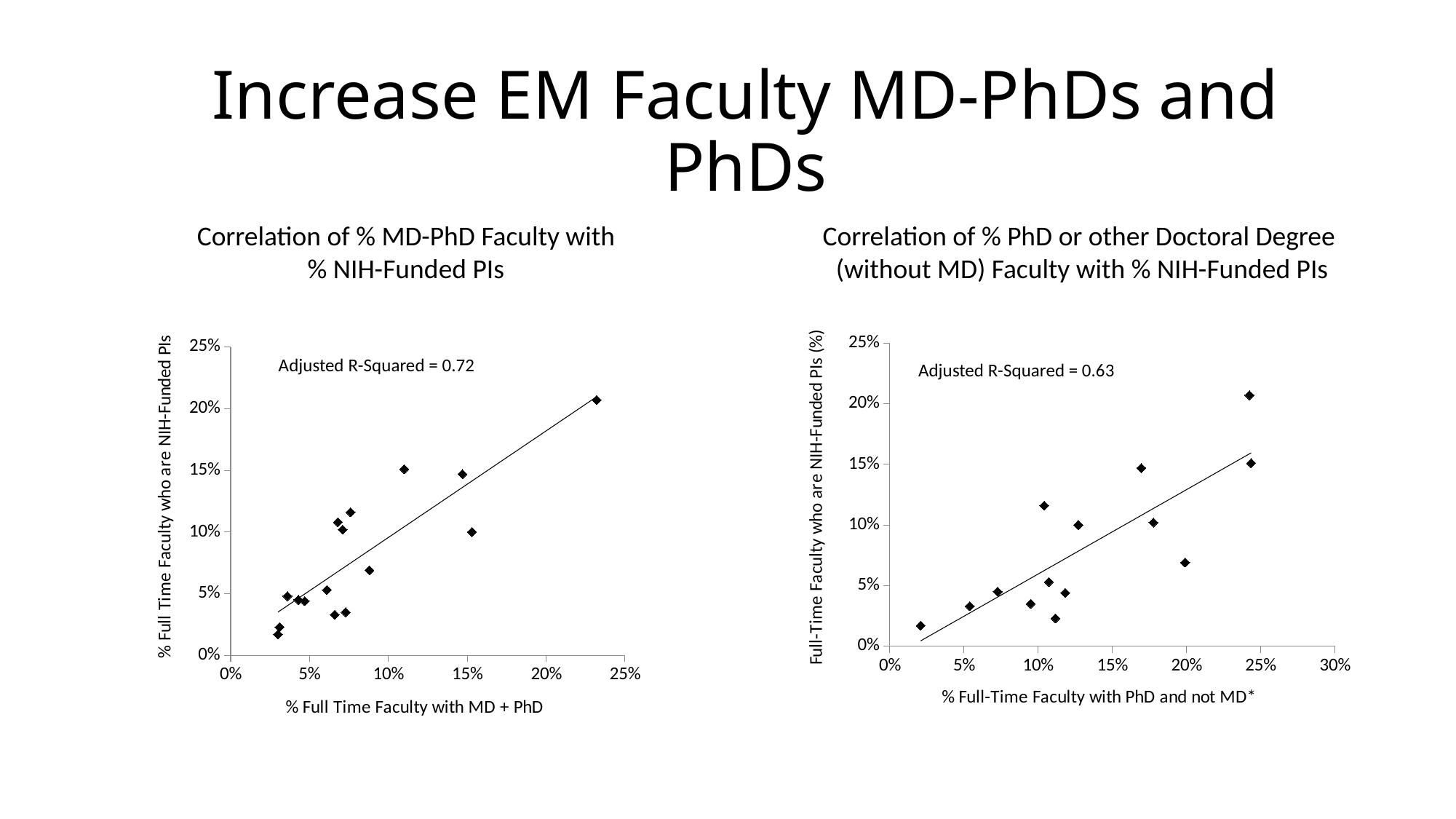
What kind of chart is the left chart, 'Correlation of % MD-PhD Faculty with % NIH-Funded PIs'? scatter plot What is the maximum value shown on the x axis of the right chart? 30% In the right chart, does the trend line rise or fall as % full-time faculty with PhD and not MD increases? rise In the left chart, do the values of % NIH-funded PIs generally rise or fall as % full time faculty with MD + PhD increases? rise In the left chart, is the y-value of the leftmost data points (at about 3% on the x axis) greater or less than 5%? less What is the Adjusted R-Squared value shown on the left chart? 0.72 What kind of chart is the right chart, 'Correlation of % PhD or other Doctoral Degree (without MD) Faculty with % NIH-Funded PIs'? scatter plot In the right chart, is the y-value of the data point at about 20% on the x axis greater or less than 10%? less Which chart reports the higher Adjusted R-Squared, the left chart (MD-PhD) or the right chart (PhD without MD)? the left chart (MD-PhD) What is the Adjusted R-Squared value shown on the right chart? 0.63 In the left chart, is the y-value of the rightmost data point (at about 23% on the x axis) greater or less than 15%? greater